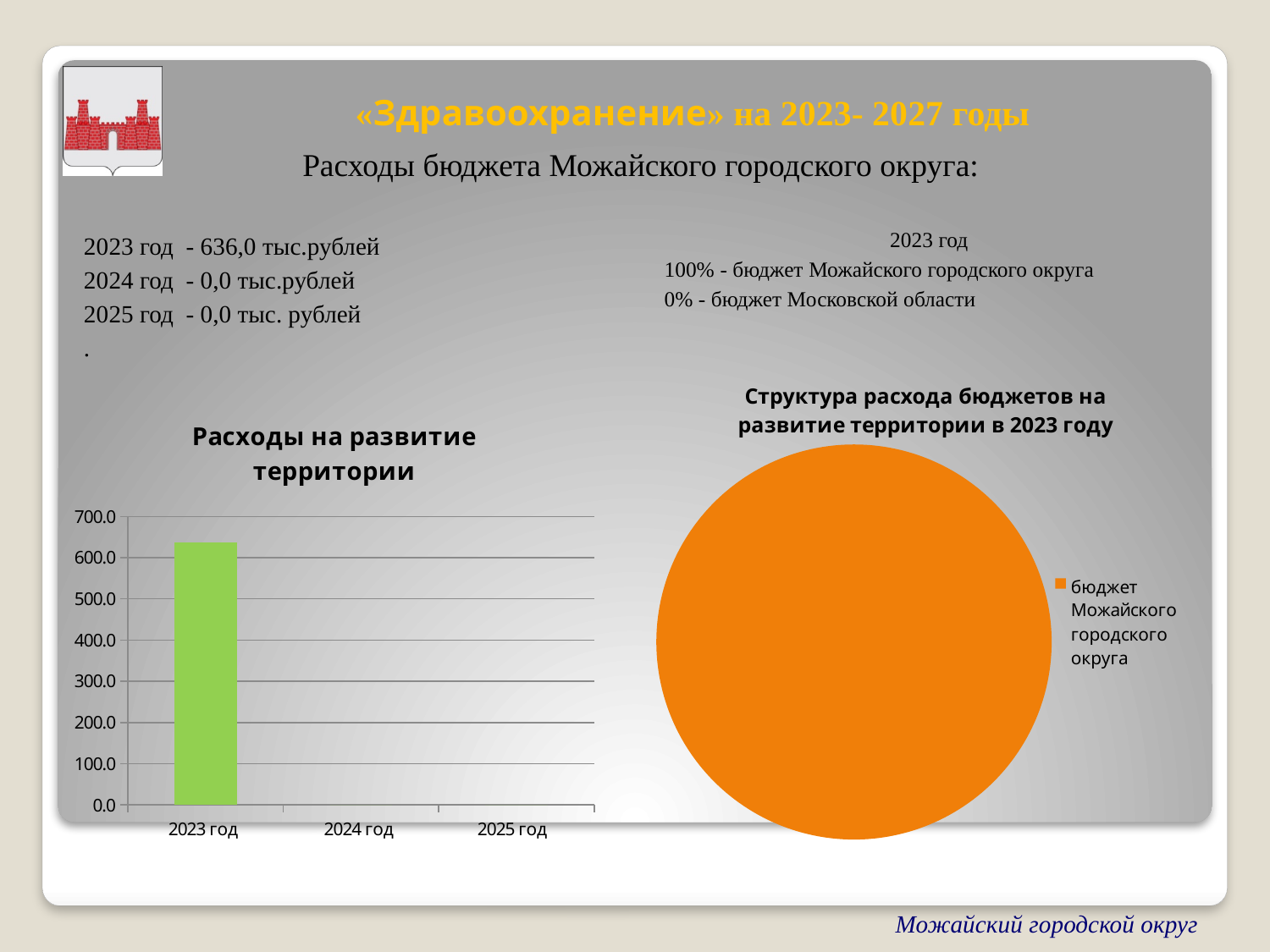
In the pie chart «Структура расхода бюджетов на развитие территории в 2023 году», how many entries does the legend list? 1 In the bar chart «Расходы на развитие территории», what is the value for 2024 год? 0.0 In the pie chart «Структура расхода бюджетов на развитие территории в 2023 году», what share does «бюджет Можайского городского округа» have? 100% In the bar chart «Расходы на развитие территории», do the values rise or fall from 2023 год to 2025 год? fall In the bar chart «Расходы на развитие территории», is the value for 2023 год greater or less than 600? greater In the bar chart «Расходы на развитие территории», is the value for 2023 год greater or less than 700? less What kind of chart is the chart titled «Расходы на развитие территории»? bar chart In the bar chart «Расходы на развитие территории», which is larger, the value for 2023 год or the value for 2024 год? 2023 год In the bar chart «Расходы на развитие территории», what is the value for 2025 год? 0.0 In the bar chart «Расходы на развитие территории», how many categories are shown on the x axis? 3 What kind of chart is the chart titled «Структура расхода бюджетов на развитие территории в 2023 году»? pie chart In the bar chart «Расходы на развитие территории», which year has the highest value? 2023 год